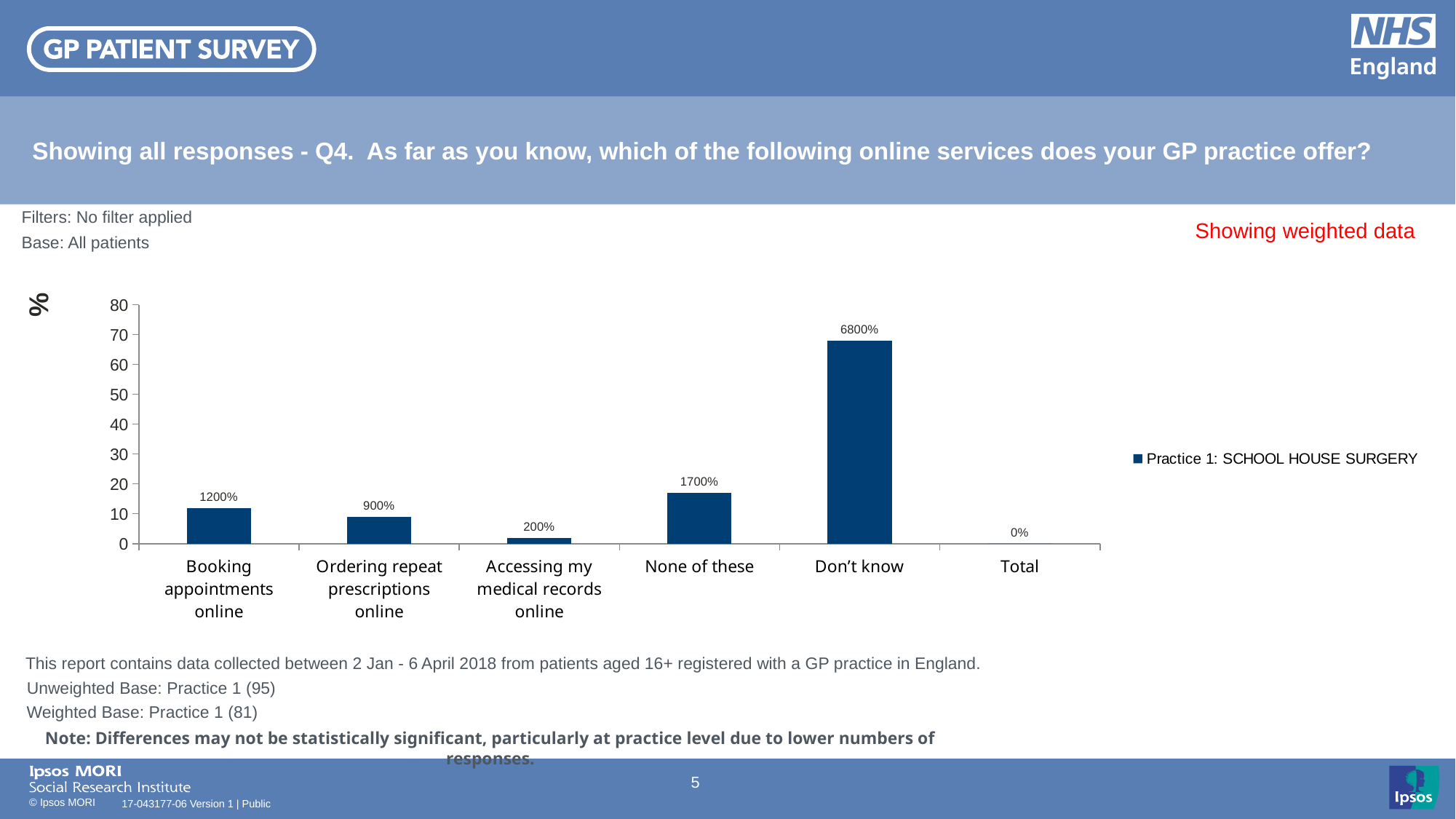
What is the data label shown for 'Don't know'? 6800% What is the data label shown for 'None of these'? 1700% What is the data label shown for 'Booking appointments online'? 1200% Which is larger: the bar for 'Booking appointments online' or the bar for 'Ordering repeat prescriptions online'? Booking appointments online What is the data label shown for 'Total'? 0% What is the name of the series listed in the legend? Practice 1: SCHOOL HOUSE SURGERY How many categories are shown on the x axis? 6 Which category has the tallest bar? Don't know What is the data label shown for 'Ordering repeat prescriptions online'? 900% What type of chart is shown on the slide? Bar chart Which category has the lowest value? Total What is the data label shown for 'Accessing my medical records online'? 200%